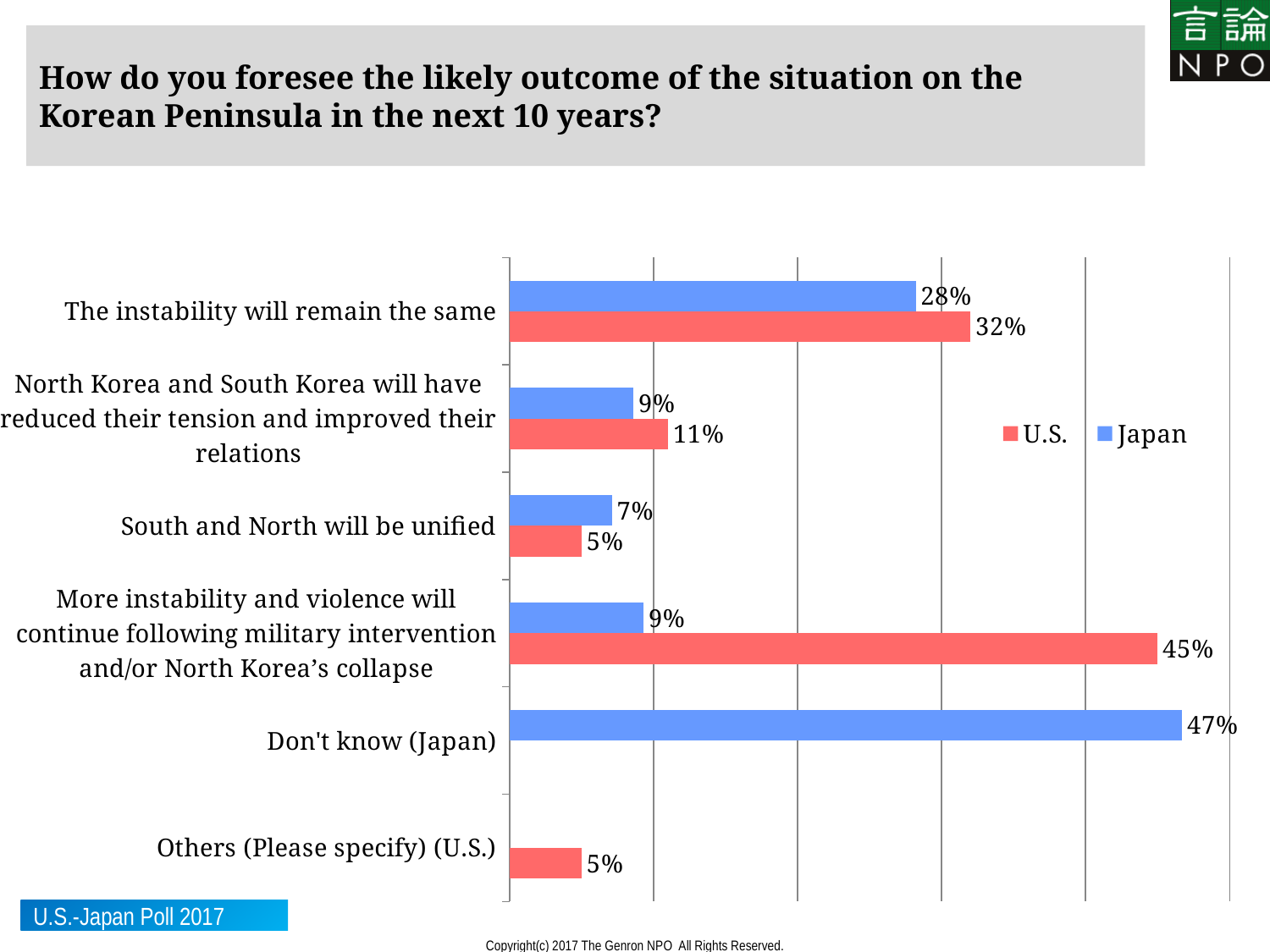
What is the U.S. value for "More instability and violence will continue following military intervention and/or North Korea's collapse"? 45% How many series does the legend list? 2 Which series is shown in red in the legend? U.S. What kind of chart is shown on the slide? bar chart What is the U.S. value for "The instability will remain the same"? 32% Which category has the highest Japan value? Don't know (Japan) What is the Japan value for "Don't know (Japan)"? 47% What is the Japan value for "South and North will be unified"? 7% What is the difference between the U.S. and Japan values for "More instability and violence will continue following military intervention and/or North Korea's collapse"? 36% Which category has the highest U.S. value? More instability and violence will continue following military intervention and/or North Korea's collapse For "South and North will be unified", which is larger, the U.S. value or the Japan value? Japan What is the Japan value for "The instability will remain the same"? 28%